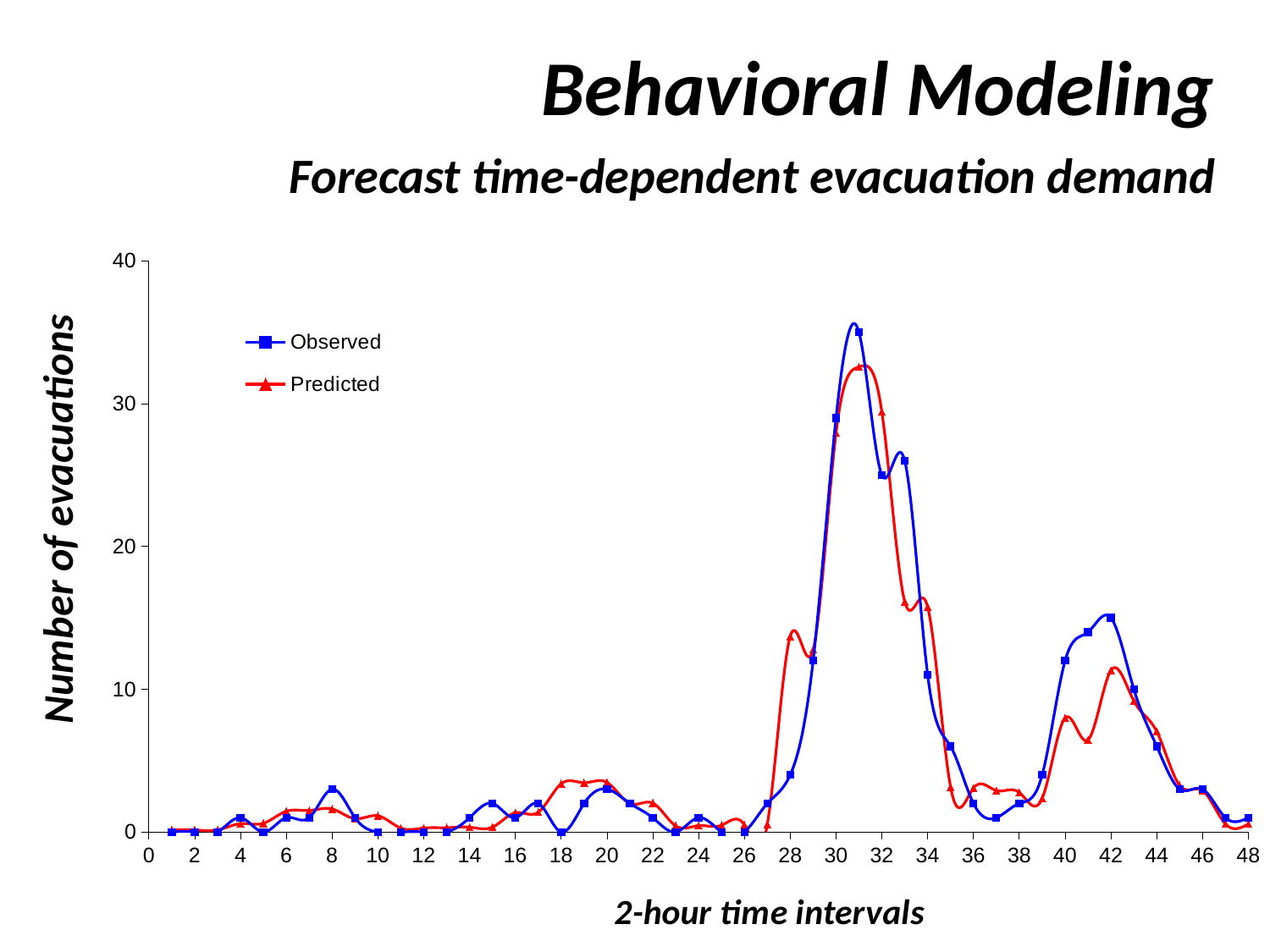
Is the Predicted value at interval 28 greater or less than 10? greater Is the Observed value at interval 31 greater or less than 30? greater What kind of chart is shown on the slide? Line chart What are the two series named in the legend? Observed and Predicted How many series does the legend list? 2 What is the title of the y axis? Number of evacuations Which series reaches the highest peak on the chart? Observed Is the Observed value at interval 33 greater or less than 20? greater At interval 31, which series has the larger value, Observed or Predicted? Observed At interval 28, which series has the larger value, Observed or Predicted? Predicted